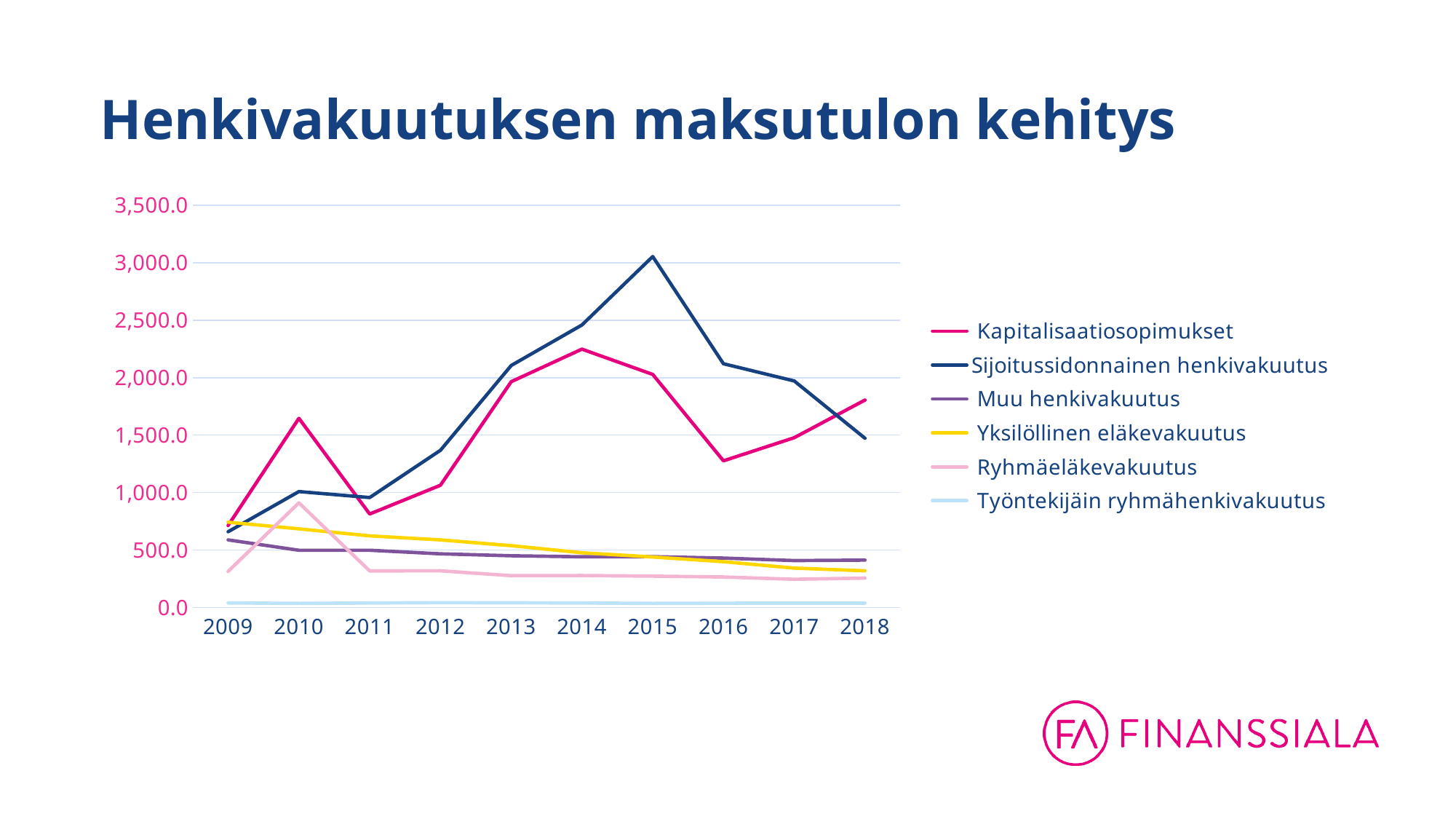
How many years are shown on the x axis? 10 What is the title of the chart? Henkivakuutuksen maksutulon kehitys How many series does the legend list? 6 Which series has the lowest values across all years? Työntekijäin ryhmähenkivakuutus Is the value for Sijoitussidonnainen henkivakuutus in 2015 greater or less than 2,500.0? greater In which year does Kapitalisaatiosopimukset reach its highest value? 2014 Is the value for Muu henkivakuutus in 2018 greater or less than 500.0? less Is the value for Kapitalisaatiosopimukset in 2016 greater or less than 1,500.0? less What kind of chart is shown on the slide? line chart In which year does Sijoitussidonnainen henkivakuutus reach its highest value? 2015 In 2018, which is higher: Kapitalisaatiosopimukset or Sijoitussidonnainen henkivakuutus? Kapitalisaatiosopimukset Does the Yksilöllinen eläkevakuutus line rise or fall from 2009 to 2018? fall